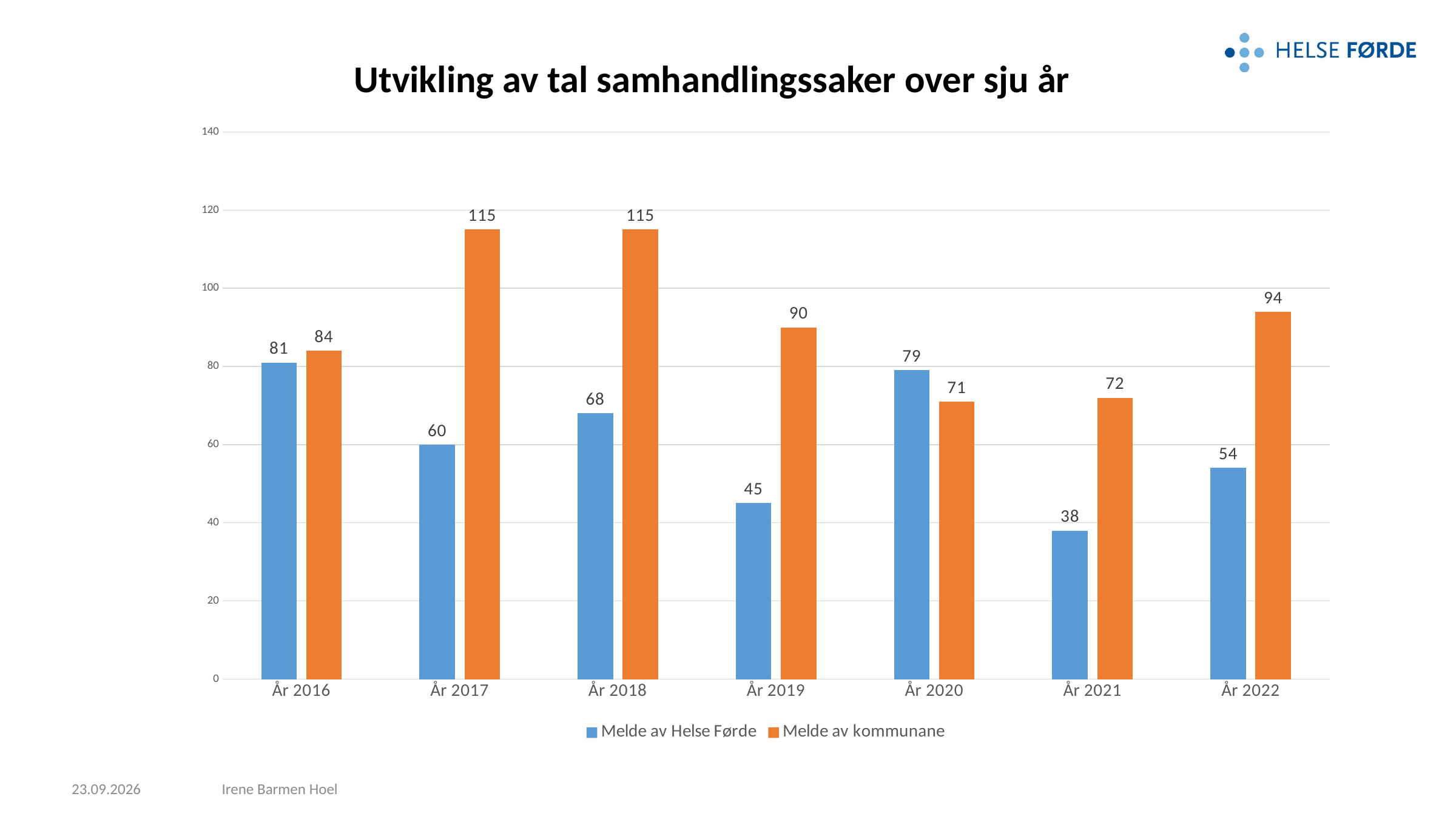
What is the value for Melde av Helse Førde in År 2016? 81 How many series does the legend list? 2 What is the value for Melde av Helse Førde in År 2021? 38 What is the title of the chart? Utvikling av tal samhandlingssaker over sju år What is the difference between Melde av kommunane and Melde av Helse Førde in År 2022? 40 Which colour represents Melde av kommunane in the chart? Orange How many years are shown on the x axis? 7 In År 2020, which series has the larger value, Melde av Helse Førde or Melde av kommunane? Melde av Helse Førde What kind of chart is shown on the slide? Bar chart Which year has the highest value for Melde av Helse Førde? År 2016 What is the value for Melde av kommunane in År 2019? 90 Which year has the lowest value for Melde av Helse Førde? År 2021